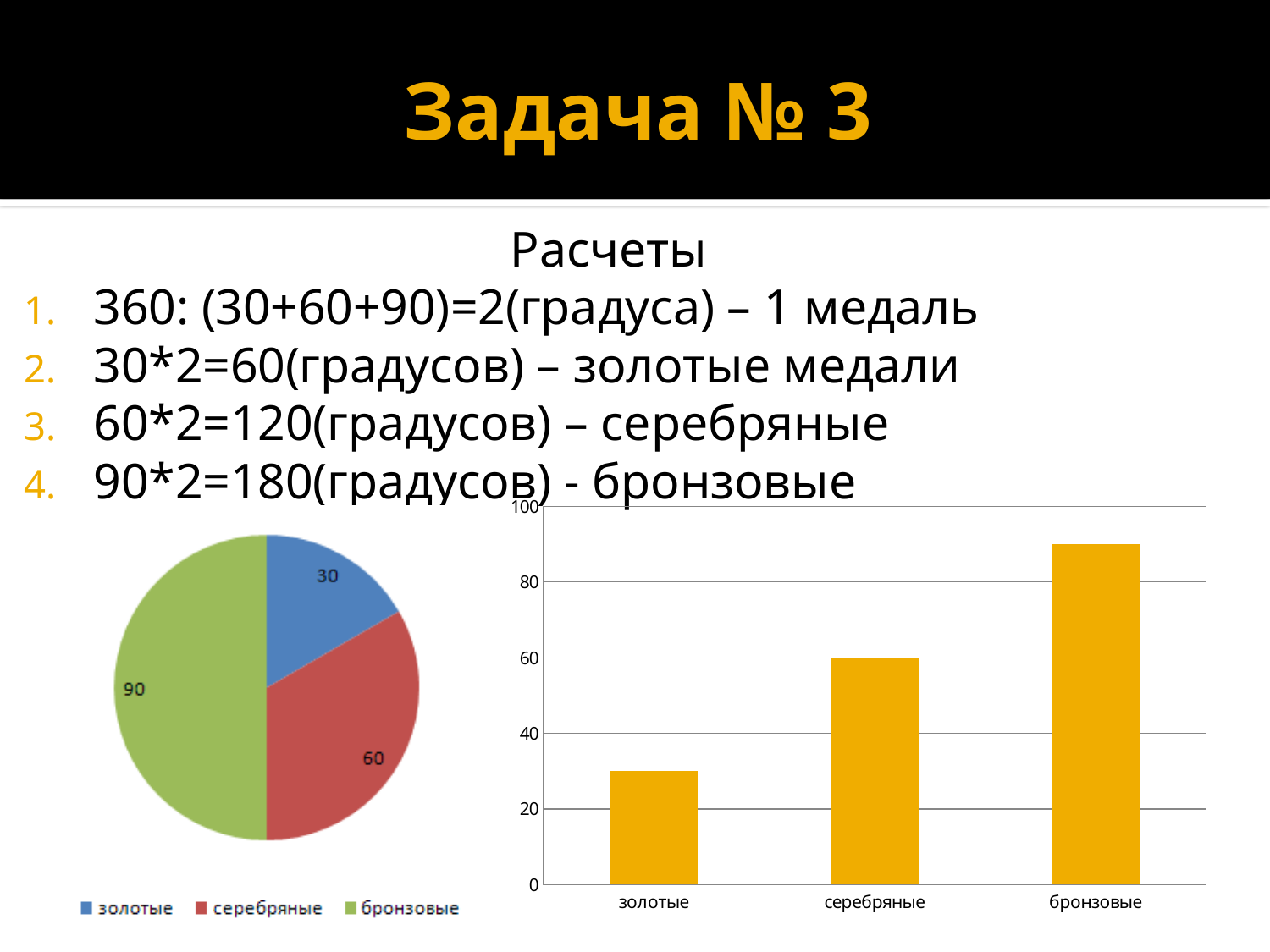
In the pie chart on the left, what value is shown for бронзовые? 90 In the bar chart on the right, what is the value for серебряные? 60 In the pie chart on the left, what is the difference between the values for бронзовые and серебряные? 30 In the pie chart on the left, what share of the whole does the бронзовые slice represent? 50% What kind of chart is the chart on the left of the slide? pie chart In the pie chart on the left, what value is shown for золотые? 30 How many entries does the legend of the pie chart on the left list? 3 In the pie chart on the left, which category has the smallest slice? золотые In the bar chart on the right, do the values rise or fall from left to right along the x axis? rise In the pie chart on the left, which category has the largest slice? бронзовые What kind of chart is the chart on the right of the slide? bar chart In the bar chart on the right, is the value for бронзовые greater or less than 80? greater